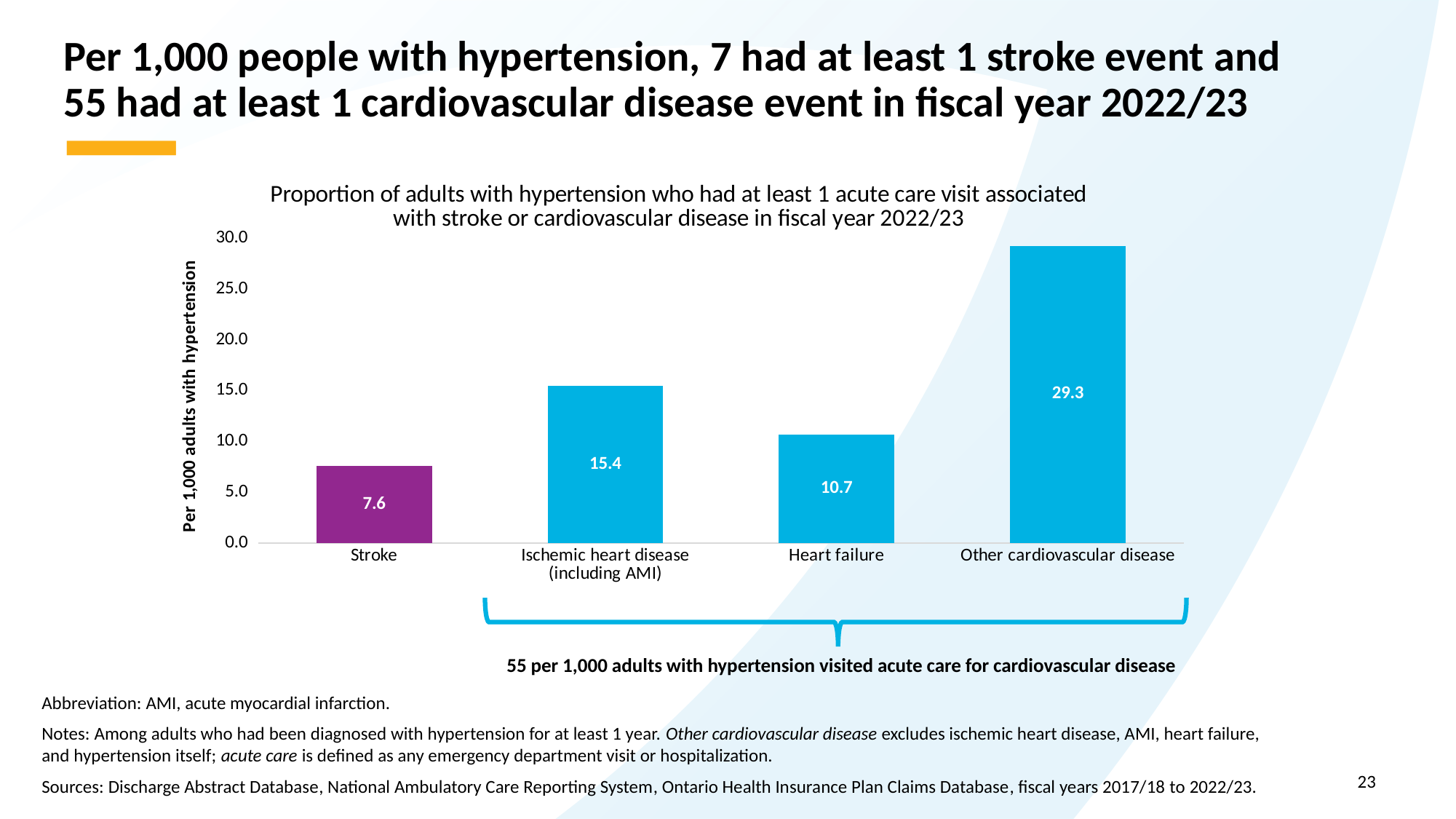
What is the value for Heart failure? 10.7 What is the label of the y axis? Per 1,000 adults with hypertension Which category has the lowest value? Stroke What is the value for Ischemic heart disease (including AMI)? 15.4 Is the value for Heart failure greater or less than 10.0? greater What kind of chart is shown on the slide? Bar chart What is the value for Other cardiovascular disease? 29.3 What is the difference between the values for Other cardiovascular disease and Ischemic heart disease (including AMI)? 13.9 Which is larger, the value for Heart failure or the value for Ischemic heart disease (including AMI)? Ischemic heart disease (including AMI) What is the value for Stroke? 7.6 Which category has the highest value? Other cardiovascular disease How many categories are shown on the x axis? 4